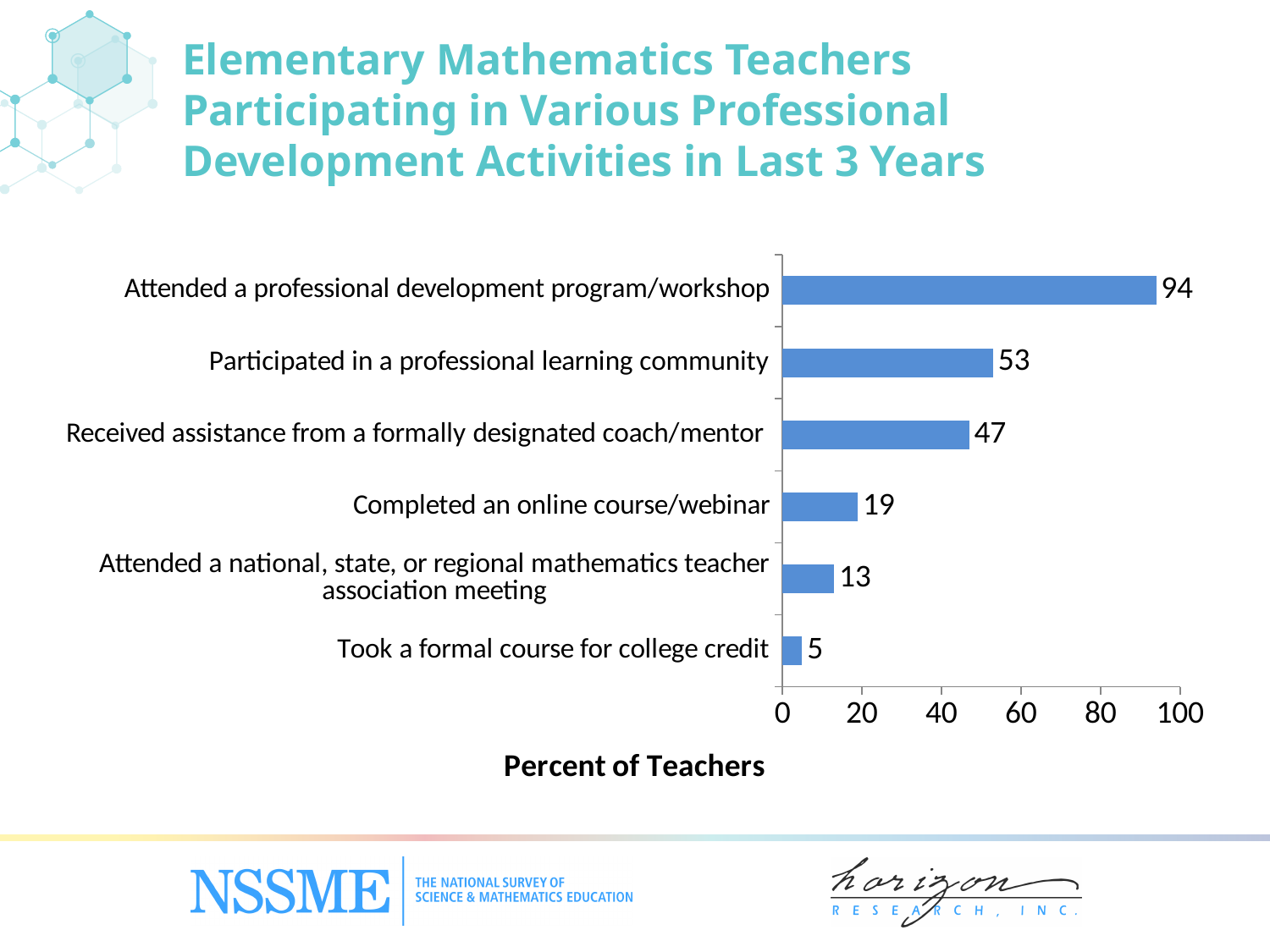
What percent of teachers attended a professional development program/workshop? 94 What is the label of the horizontal axis of the chart? Percent of Teachers Which professional development activity has the highest percent of teachers? Attended a professional development program/workshop How many professional development activities are shown in the chart? 6 What percent of teachers received assistance from a formally designated coach/mentor? 47 What is the difference in percent of teachers between participating in a professional learning community and receiving assistance from a formally designated coach/mentor? 6 Which is larger: the percent of teachers who completed an online course/webinar or the percent who attended a national, state, or regional mathematics teacher association meeting? Completed an online course/webinar What percent of teachers took a formal course for college credit? 5 What kind of chart is shown on the slide? Bar chart What percent of teachers completed an online course/webinar? 19 What percent of teachers participated in a professional learning community? 53 Which professional development activity has the lowest percent of teachers? Took a formal course for college credit